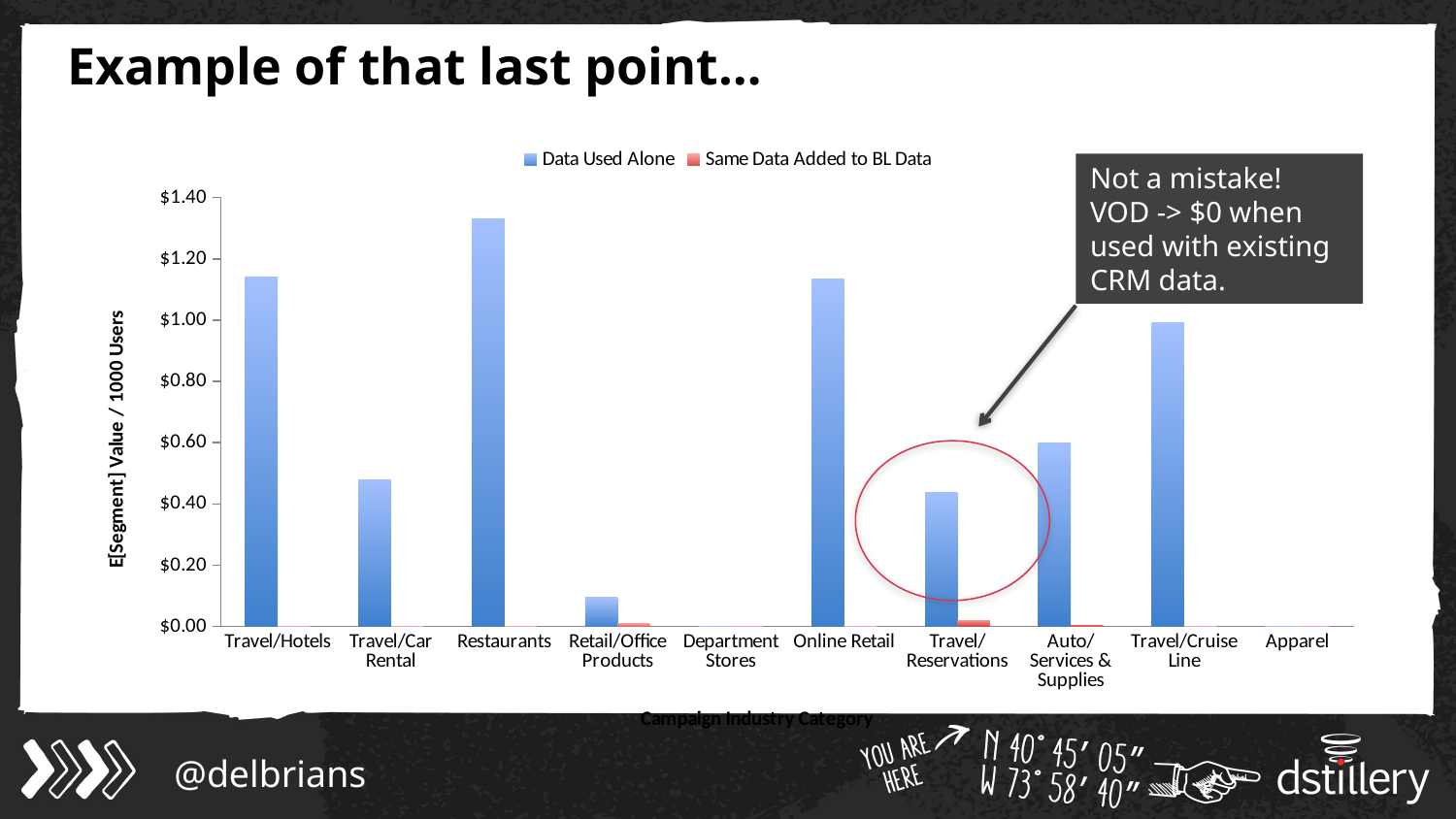
What kind of chart is shown on the slide? bar chart Which is larger for Data Used Alone: Restaurants or Online Retail? Restaurants Is the Data Used Alone value for Retail/Office Products greater or less than $0.20? less What is the title of the y axis? E[Segment] Value / 1000 Users Which category has the highest value for Data Used Alone? Restaurants Is the Data Used Alone value for Restaurants greater or less than $1.20? greater Is the Data Used Alone value for Travel/Hotels greater or less than $1.00? greater How many series does the legend list? 2 How many campaign industry categories are shown on the x axis? 10 Which is larger for Data Used Alone: Travel/Cruise Line or Auto/Services & Supplies? Travel/Cruise Line